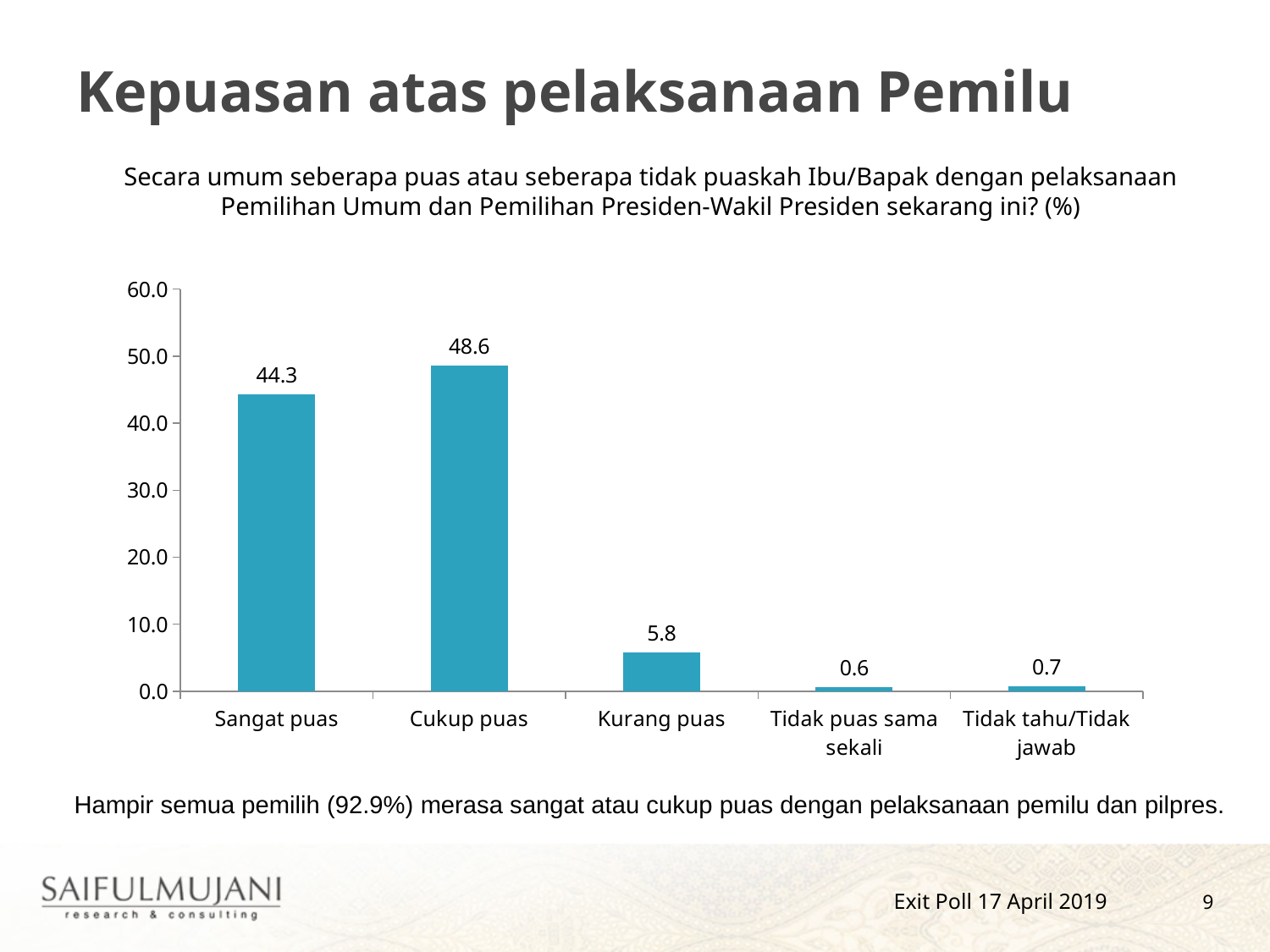
How many categories are shown on the x axis? 5 What is the value for Cukup puas? 48.6 Is the value for Sangat puas greater or less than 40.0? greater What kind of chart is shown on the slide? Bar chart What is the value for Kurang puas? 5.8 Which is larger, the value for Kurang puas or the value for Tidak tahu/Tidak jawab? Kurang puas What is the value for Tidak tahu/Tidak jawab? 0.7 What is the value for Sangat puas? 44.3 What is the value for Tidak puas sama sekali? 0.6 Which category has the lowest value? Tidak puas sama sekali What is the difference between the values for Cukup puas and Sangat puas? 4.3 Which category has the highest value? Cukup puas